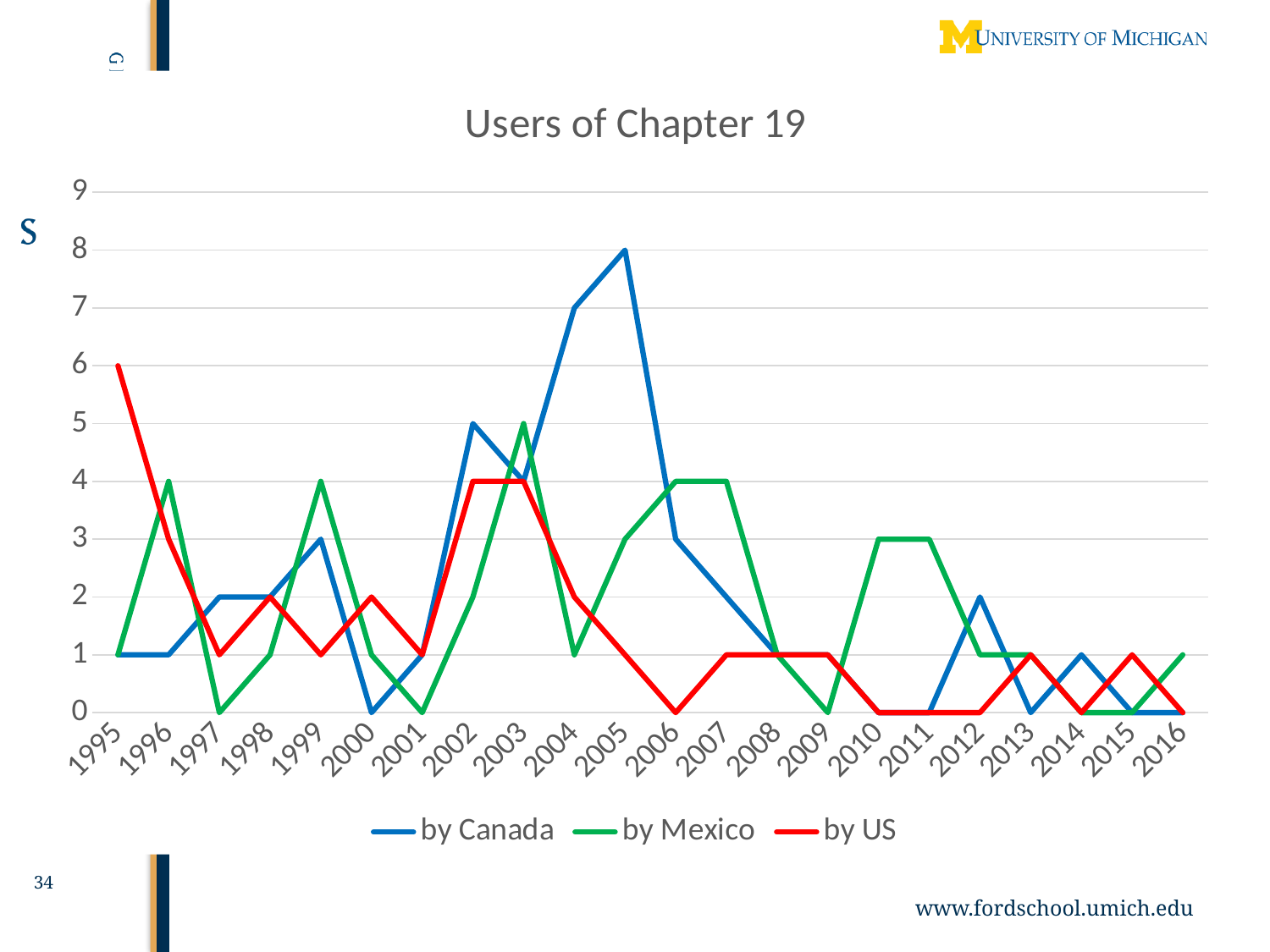
What is the difference between 'by Canada' and 'by Mexico' in 2005? 5 In 1996, which series is larger, 'by Mexico' or 'by Canada'? by Mexico What is the title of the chart? Users of Chapter 19 What is the value for 'by US' in 1995? 6 How many years are shown on the x axis? 22 What is the value for 'by Mexico' in 2003? 5 Does the 'by US' series rise or fall from 1995 to 1997? fall What kind of chart is shown on the slide? line chart Is the value for 'by Canada' in 2004 greater or less than 5? greater What is the value for 'by Canada' in 2005? 8 In which year does the 'by Canada' series reach its highest value? 2005 How many series does the legend list? 3